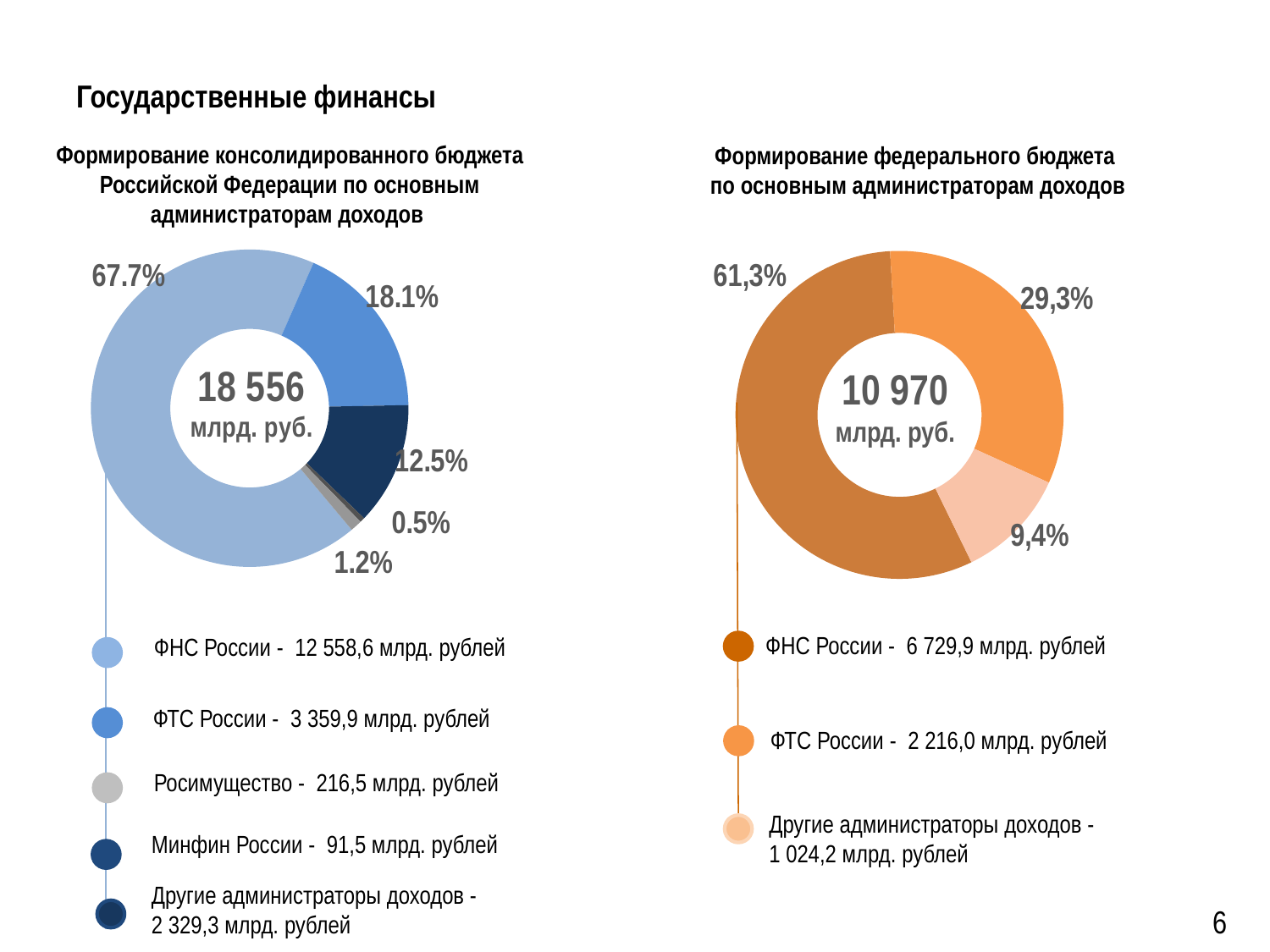
In the right chart (федеральный бюджет), what share does ФТС России hold? 29,3% In the right chart (федеральный бюджет), how many categories are shown? 3 In the right chart (федеральный бюджет), what is the value for 'Другие администраторы доходов'? 1 024,2 млрд. рублей In the left chart (консолидированный бюджет), which administrator has the smallest share? Минфин России In the right chart (федеральный бюджет), which administrator has the largest share? ФНС России In the left chart (консолидированный бюджет), how many categories are shown in the legend? 5 In the left chart (консолидированный бюджет), what is the value for ФТС России in млрд. рублей? 3 359,9 млрд. рублей What total is printed in the centre of the left chart (консолидированный бюджет)? 18 556 млрд. руб. In the left chart (консолидированный бюджет), what share does ФНС России hold? 67.7% What type of chart is used on the left, 'Формирование консолидированного бюджета Российской Федерации по основным администраторам доходов'? Donut (pie) chart Which is larger: the ФНС России value in the left chart (консолидированный бюджет) or the ФНС России value in the right chart (федеральный бюджет)? Left chart (12 558,6 млрд. рублей) In the left chart (консолидированный бюджет), what is the difference in percentage points between the ФТС России share and the 'Другие администраторы доходов' share? 5.6 percentage points